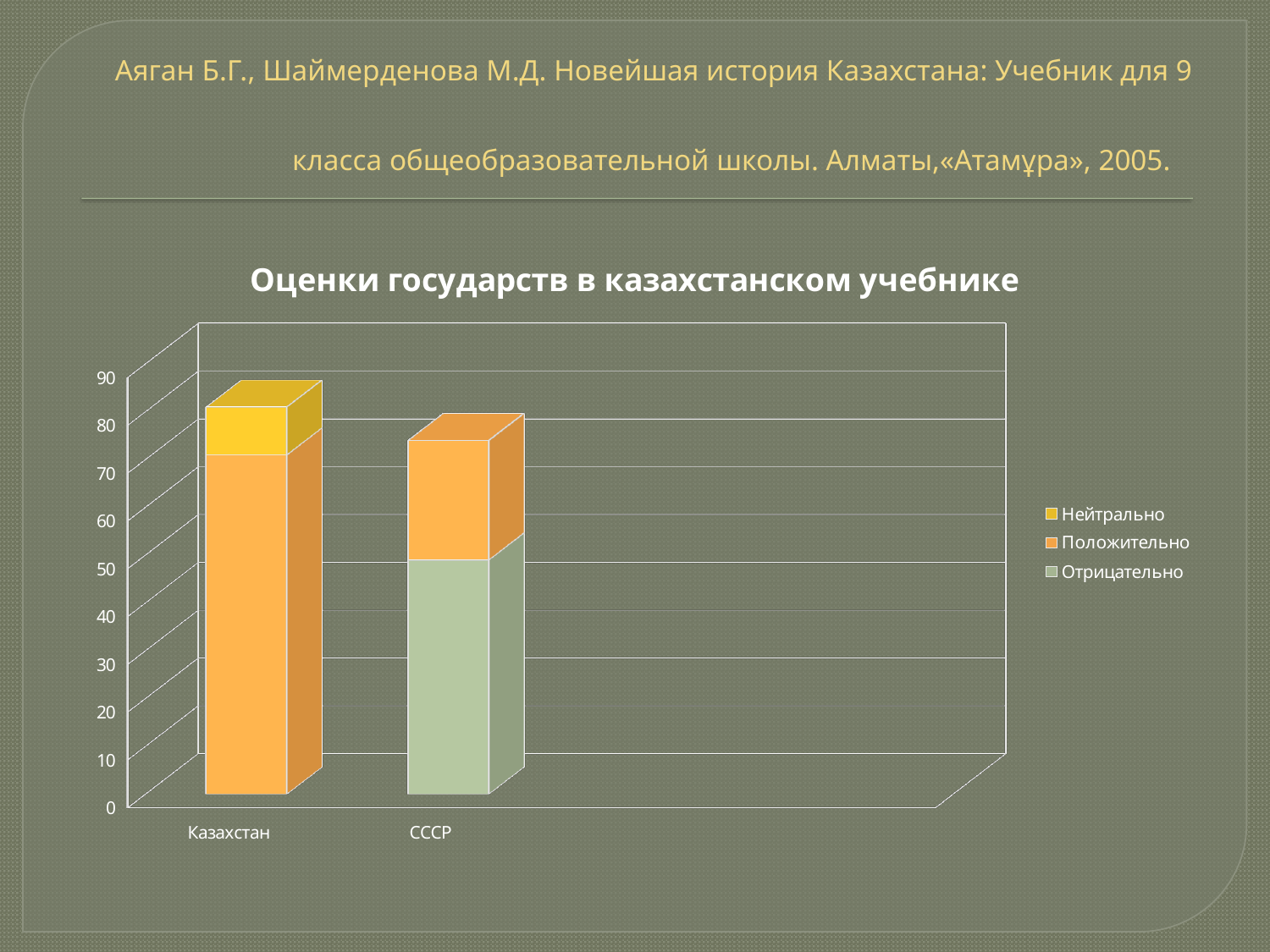
What kind of chart is shown on the slide? stacked bar chart What is the title of the chart? Оценки государств в казахстанском учебнике Is the Нейтрально value for Казахстан greater or less than 20? less Is the Положительно value for Казахстан greater or less than 60? greater Is the Отрицательно value for СССР greater or less than 40? greater How many categories are shown on the x axis of the chart? 2 How many series does the chart legend list? 3 Which category has the taller stacked bar overall, Казахстан or СССР? Казахстан Which series are listed in the chart legend? Нейтрально, Положительно, Отрицательно Which category has a Нейтрально segment in its bar? Казахстан